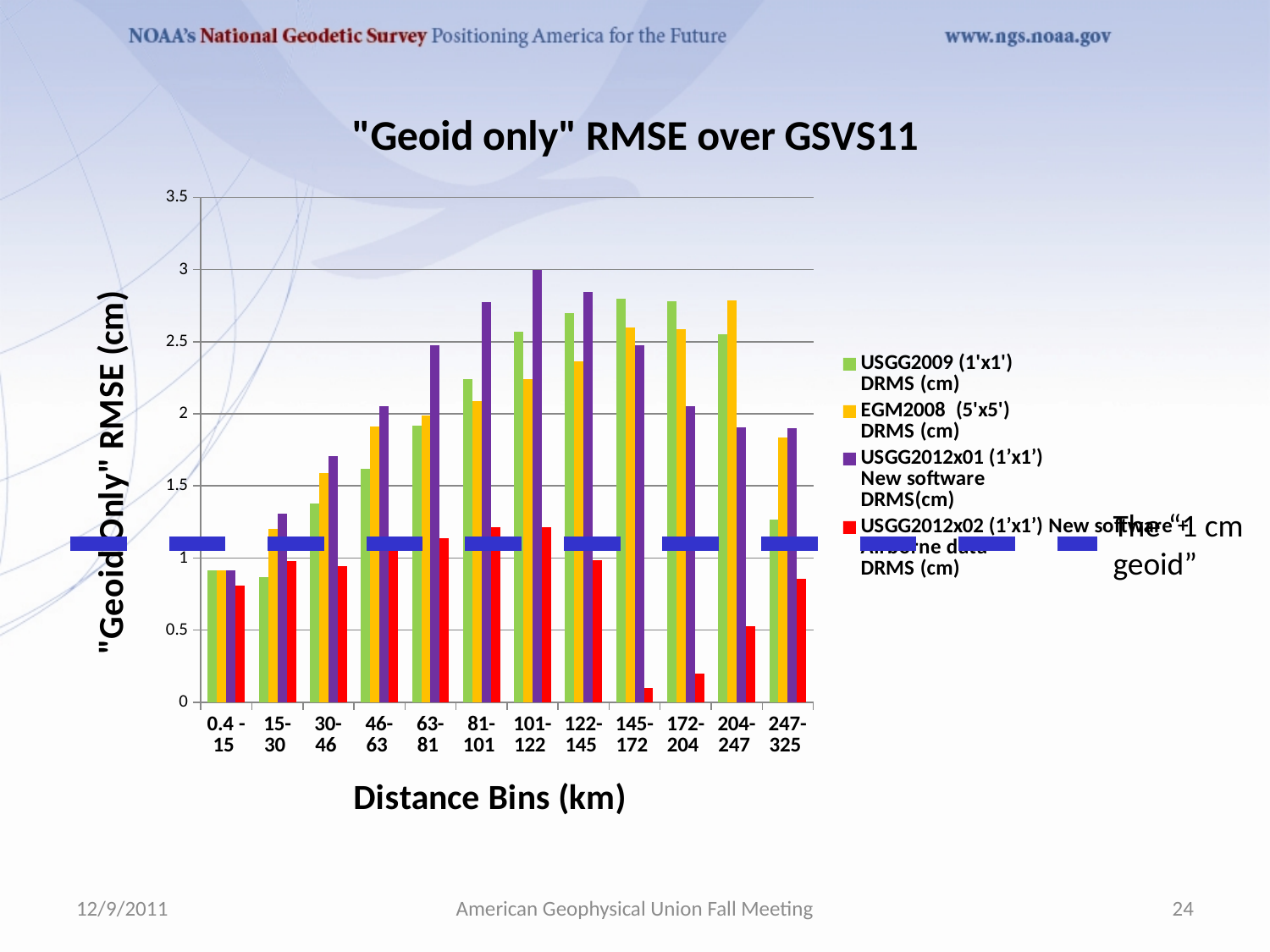
How many series does the chart's legend list? 4 What kind of chart is shown on the slide? bar chart For which distance bin is the USGG2012x02 (1'x1') New software + Airborne data DRMS value lowest? 145-172 What is the title of the chart? "Geoid only" RMSE over GSVS11 How many distance bins are shown on the x axis of the chart? 12 Does the USGG2012x01 (1'x1') New software DRMS value rise or fall from the 0.4-15 bin to the 101-122 bin? rise What is the x-axis title of the chart? Distance Bins (km) For which distance bin is the USGG2012x01 (1'x1') New software DRMS value highest? 101-122 In the 145-172 distance bin, which is larger: the USGG2009 (1'x1') DRMS value or the USGG2012x02 (1'x1') New software + Airborne data DRMS value? USGG2009 (1'x1') DRMS Is the USGG2012x01 (1'x1') New software DRMS value for the 101-122 bin greater or less than 2.5? greater For which distance bin is the EGM2008 (5'x5') DRMS value highest? 204-247 Is the USGG2012x02 (1'x1') New software + Airborne data DRMS value for the 172-204 bin greater or less than 0.5? less